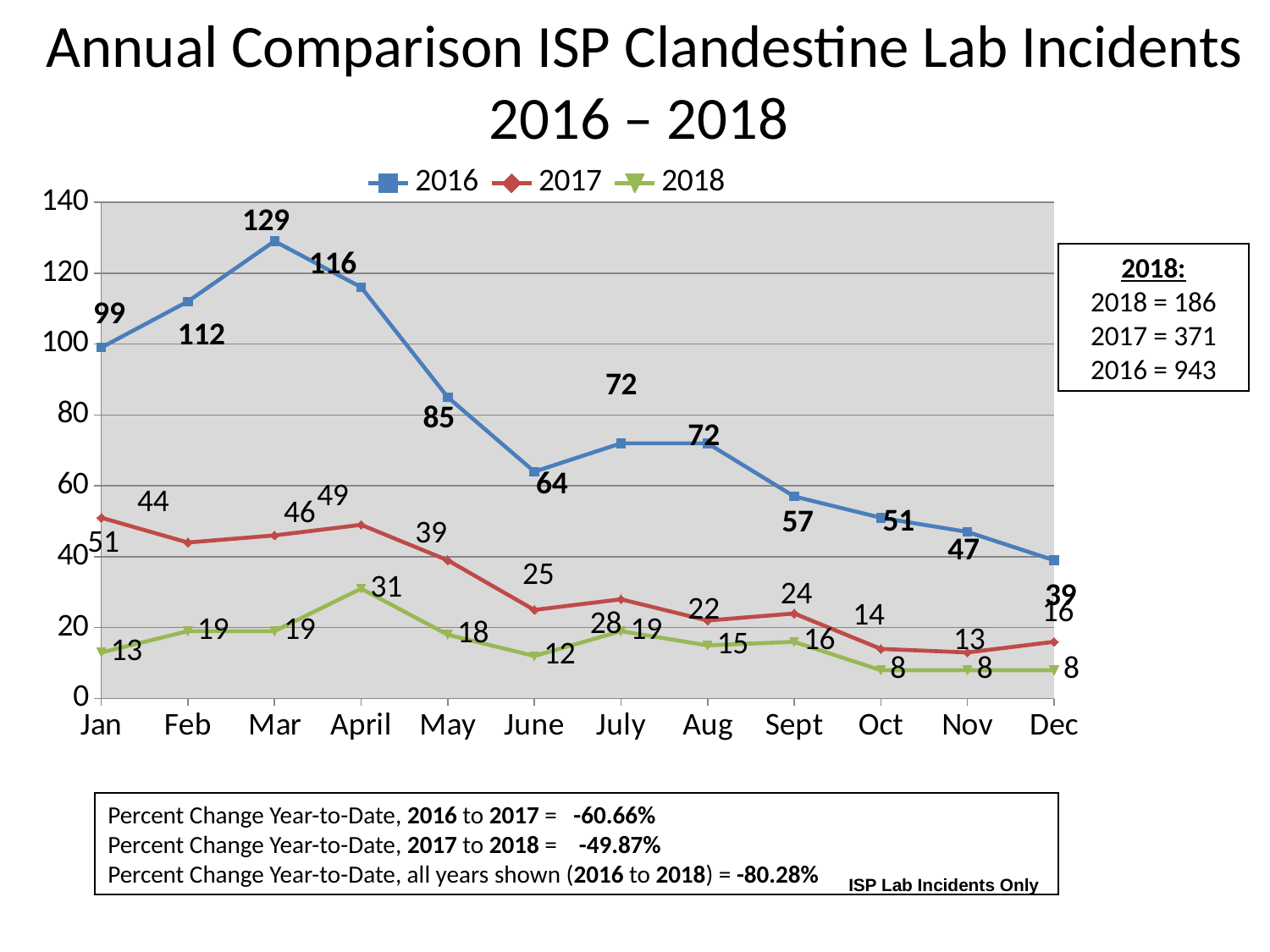
According to the box on the right, what is the total for 2016? 943 In which month is the 2016 series highest? Mar What is the value for 2017 in May? 39 Does the 2016 series generally rise or fall from April to December? Fall How many series does the legend list? 3 Which is larger, the 2017 value in April or the 2018 value in April? 2017 What is the value for 2018 in April? 31 What is the difference between the 2016 and 2017 values in January? 48 How many months are plotted along the x axis? 12 In which month is the 2017 series lowest? Nov What type of chart is shown on the slide? Line chart What is the value for 2016 in March? 129